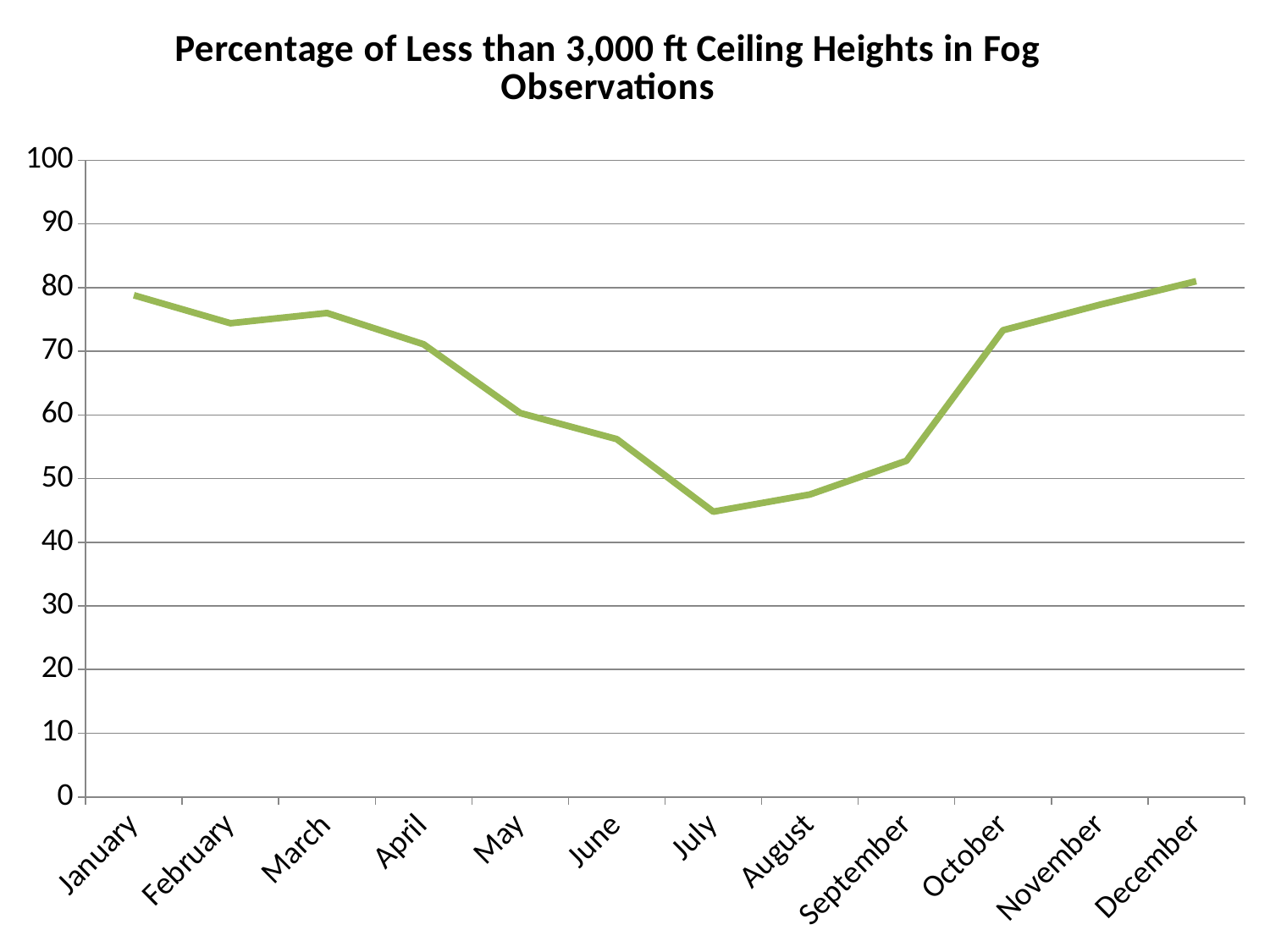
Which month has the highest percentage? December Do the values rise or fall from January to July? fall Is the value for July greater or less than 50? less Is the value for May greater or less than 70? less What kind of chart is shown on the slide? line chart What is the title of the chart? Percentage of Less than 3,000 ft Ceiling Heights in Fog Observations Which is larger, the value for August or the value for November? November Is the value for December greater or less than 80? greater Which is larger, the value for March or the value for June? March How many months are plotted along the x axis? 12 Which month has the lowest percentage? July